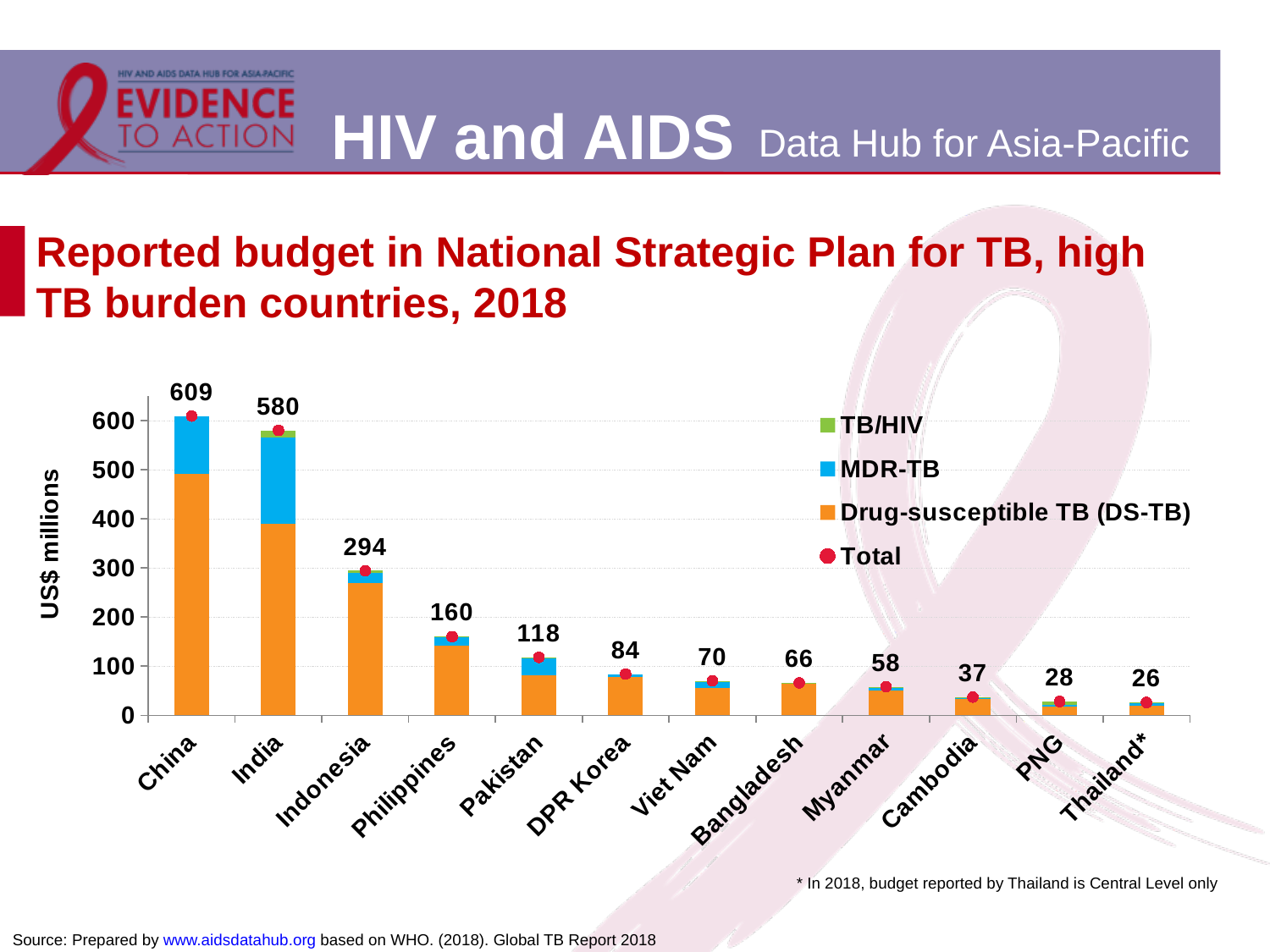
Which country has the highest total reported TB budget? China Which has a larger total budget, Pakistan or DPR Korea? Pakistan How many entries does the legend list? 4 Is the Drug-susceptible TB (DS-TB) value for India greater or less than 300? greater What is the difference between the total budgets of China and India? 29 Which country has the lowest total reported TB budget? Thailand* What is the total reported TB budget for Indonesia? 294 What is the total reported TB budget for Thailand*? 26 How many countries are shown on the x axis? 12 What is the total reported TB budget for China? 609 What kind of chart is shown on the slide? Stacked bar chart What is the unit shown on the y axis? US$ millions